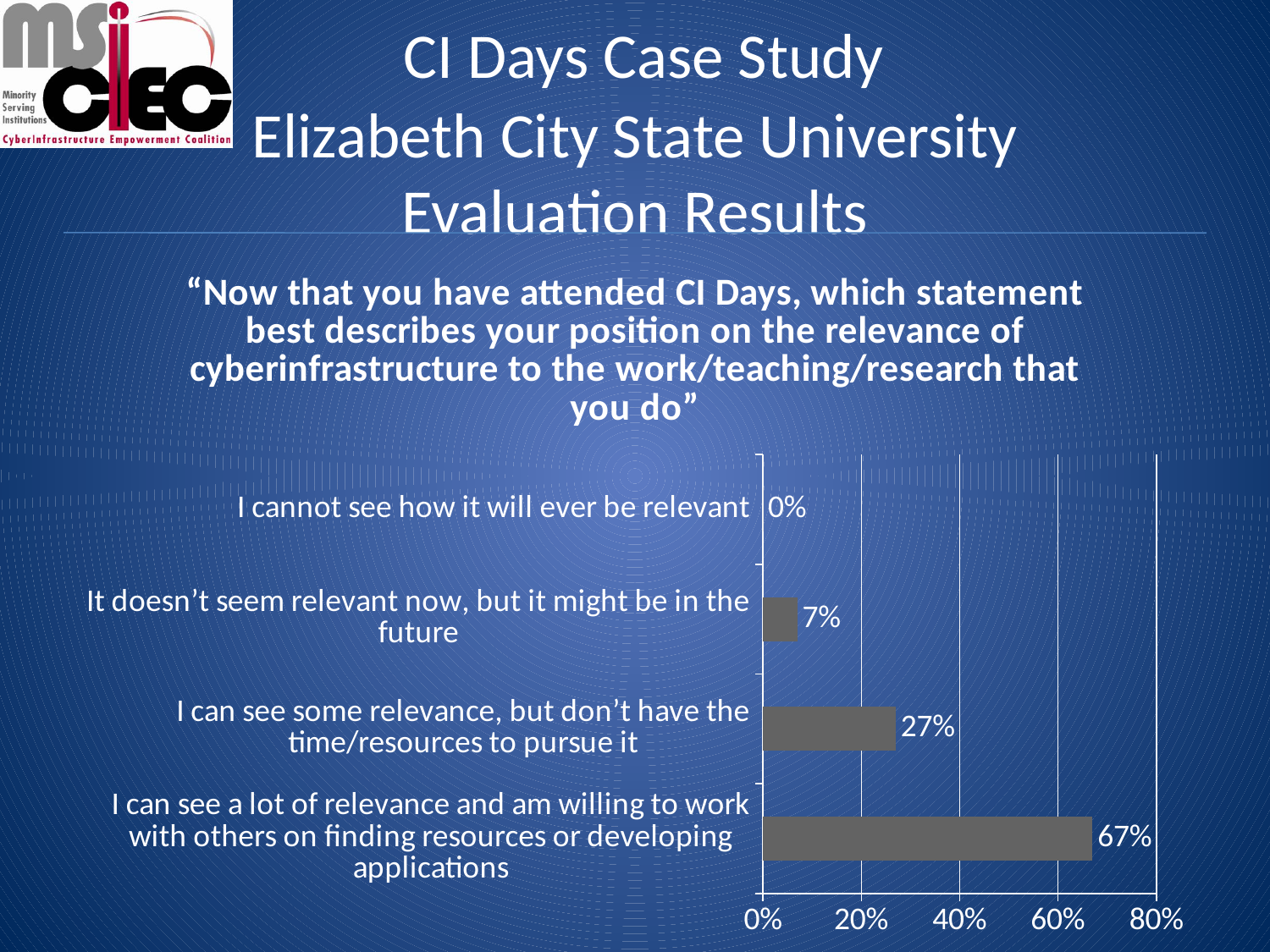
What is the difference in percentage points between "I can see a lot of relevance..." and "I can see some relevance..."? 40 percentage points What is the maximum value shown on the chart's horizontal axis? 80% What percentage of respondents chose "I cannot see how it will ever be relevant"? 0% Which statement received the lowest percentage of responses? I cannot see how it will ever be relevant Which received a larger share of responses: "It doesn't seem relevant now, but it might be in the future" or "I can see some relevance, but don't have the time/resources to pursue it"? I can see some relevance, but don't have the time/resources to pursue it What percentage of respondents chose "I can see a lot of relevance and am willing to work with others on finding resources or developing applications"? 67% How many statement categories are shown in the chart? 4 What type of chart is shown on the slide? Bar chart What percentage of respondents chose "It doesn't seem relevant now, but it might be in the future"? 7% Which statement received the highest percentage of responses? I can see a lot of relevance and am willing to work with others on finding resources or developing applications What percentage of respondents chose "I can see some relevance, but don't have the time/resources to pursue it"? 27% What is the difference in percentage points between "I can see some relevance..." and "It doesn't seem relevant now..."? 20 percentage points